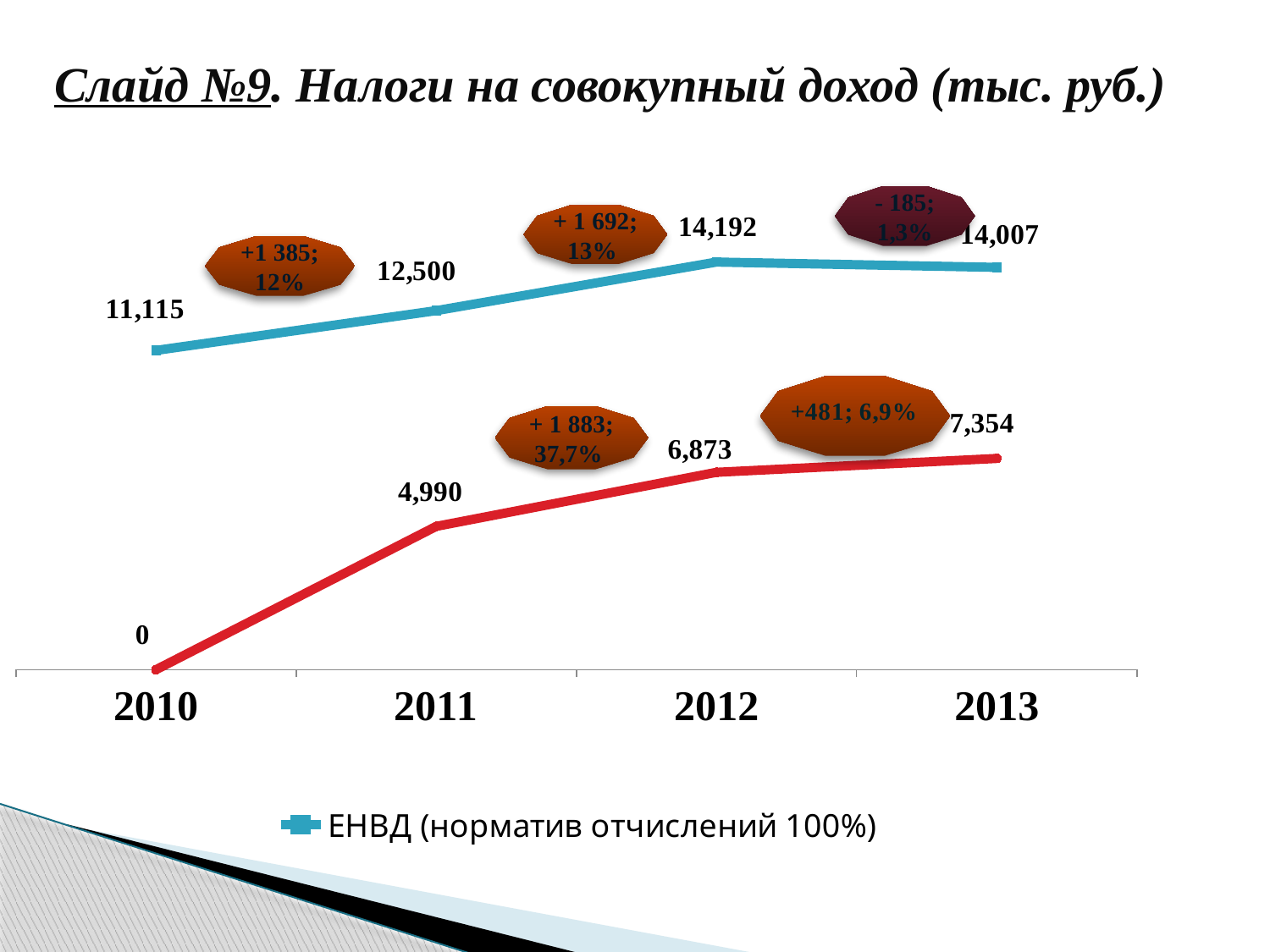
What is the value of the red line in 2013? 7,354 What is the value of ЕНВД (норматив отчислений 100%) in 2012? 14,192 Does the red line rise or fall from 2010 to 2013? rise How many years are shown on the x axis? 4 What is the difference between the ЕНВД values for 2012 and 2013? 185 In which year is the red line at its lowest value? 2010 In which year does ЕНВД (норматив отчислений 100%) reach its highest value? 2012 How many series does the legend list? 1 What type of chart is shown on the slide? line chart What is the value of ЕНВД (норматив отчислений 100%) in 2010? 11,115 What is the difference between the red line values for 2011 and 2012? 1,883 Which is larger in 2011: the ЕНВД value or the red line value? ЕНВД